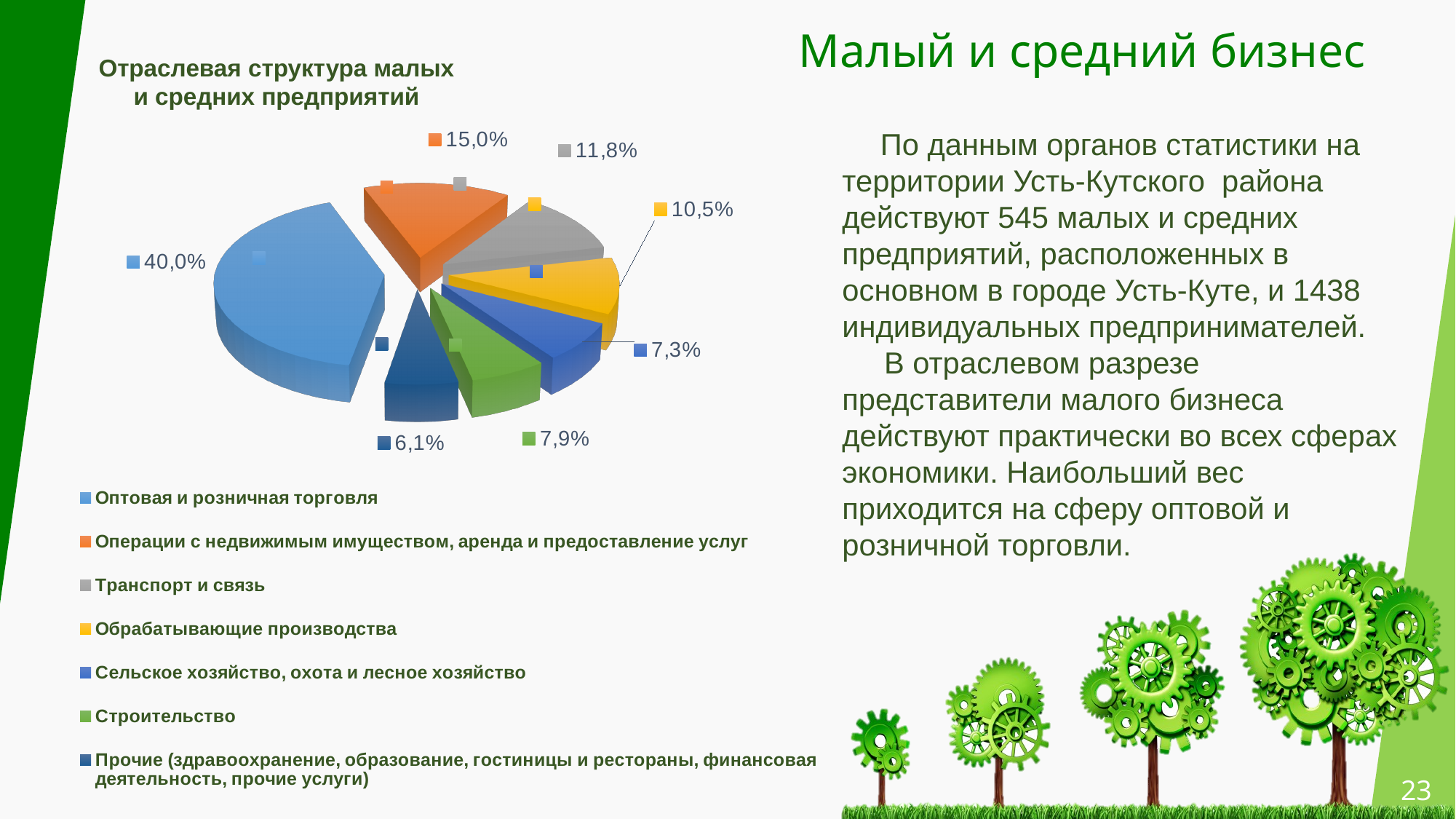
What colour is the slice for "Операции с недвижимым имуществом, аренда и предоставление услуг"? Orange Which is larger: the share of "Строительство" or the share of "Сельское хозяйство, охота и лесное хозяйство"? Строительство Which category has the smallest slice in the pie chart? Прочие (здравоохранение, образование, гостиницы и рестораны, финансовая деятельность, прочие услуги) What is the difference in percentage points between "Оптовая и розничная торговля" and "Операции с недвижимым имуществом, аренда и предоставление услуг"? 25,0 What kind of chart is shown on the slide? Pie chart What is the share of "Строительство" in the pie chart? 7,9% What is the share of "Оптовая и розничная торговля" in the pie chart? 40,0% Which category has the largest slice in the pie chart? Оптовая и розничная торговля What is the share of "Обрабатывающие производства" in the pie chart? 10,5% How many categories does the pie chart show? 7 What is the share of "Транспорт и связь" in the pie chart? 11,8% What is the title of the pie chart? Отраслевая структура малых и средних предприятий